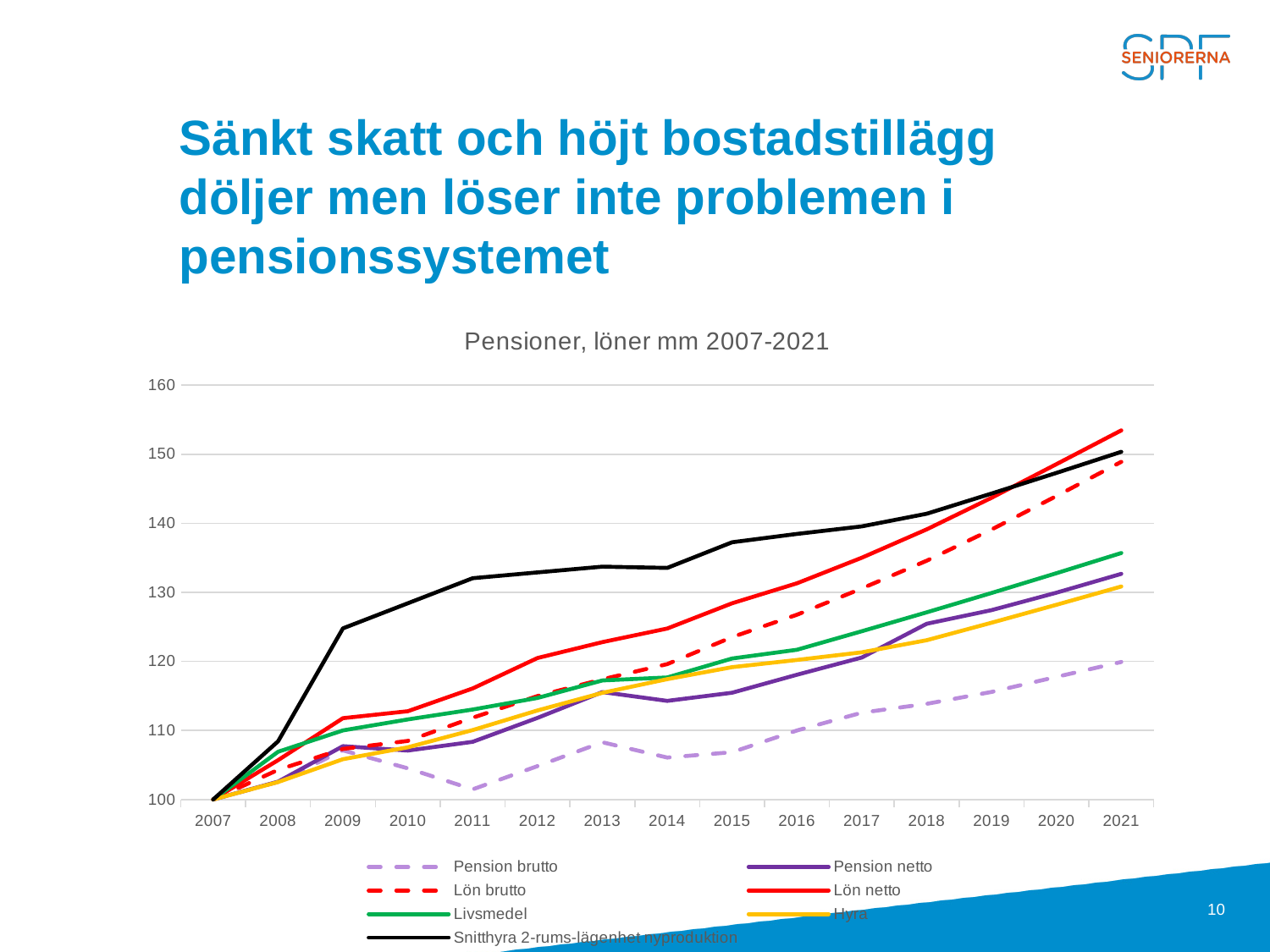
What is the title of the chart? Pensioner, löner mm 2007-2021 How many years are plotted along the x axis of the chart? 15 What is the value of Lön netto in 2007? 100 Is the value for Pension brutto in 2021 greater or less than 130? less How many series does the legend of the chart list? 7 What kind of chart is shown on the slide? line chart Does the Lön netto series rise or fall from 2007 to 2021? rise Which series has the highest value in 2015? Snitthyra 2-rums-lägenhet nyproduktion Which series has the lowest value in 2021? Pension brutto In 2021, which is higher: Livsmedel or Hyra? Livsmedel Which series has the lowest value in 2014? Pension brutto Is the value for Snitthyra 2-rums-lägenhet nyproduktion in 2009 greater or less than 120? greater